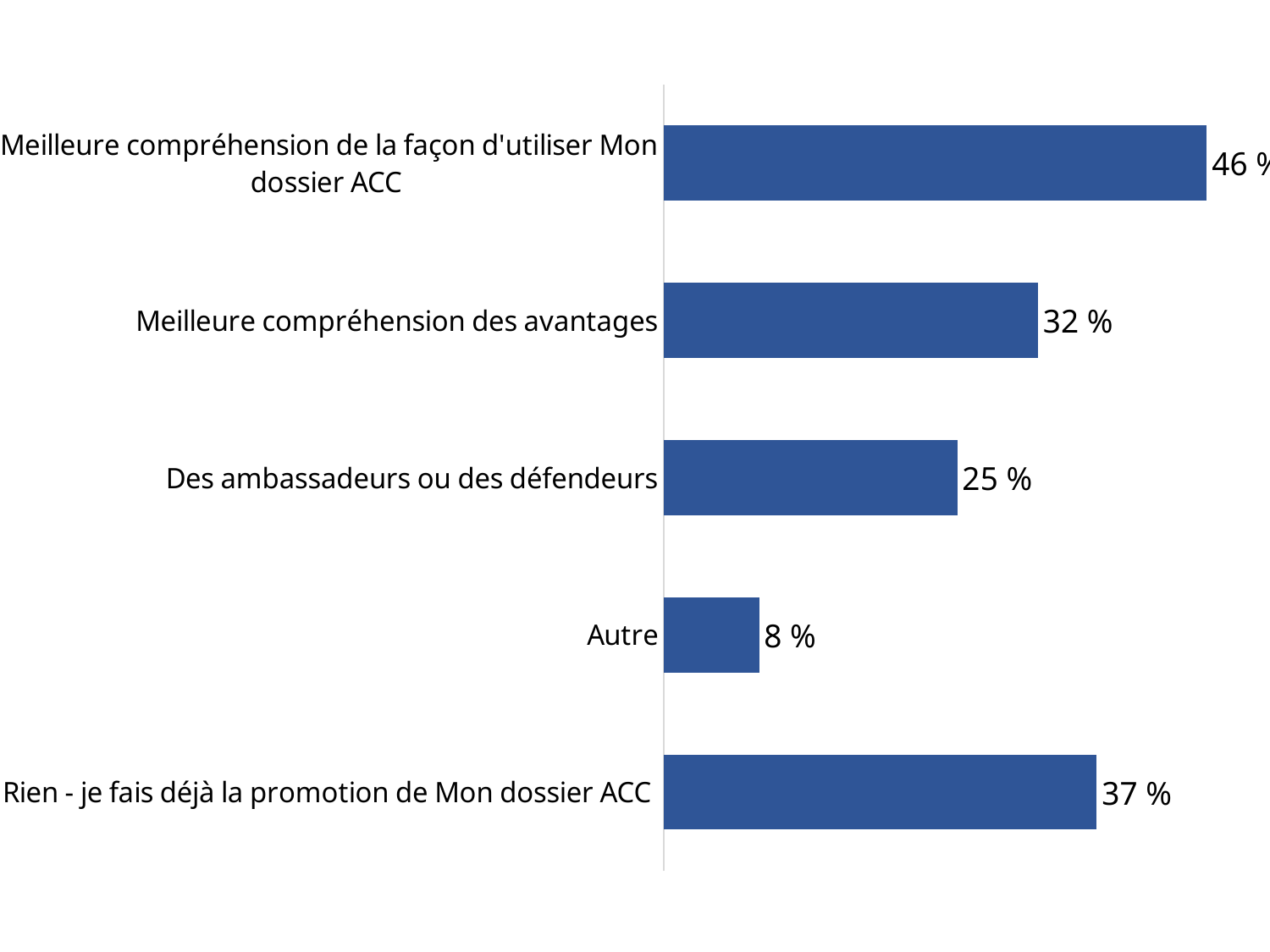
What is the value for "Autre"? 8 % What kind of chart is shown on the slide? Bar chart What is the value for "Des ambassadeurs ou des défendeurs"? 25 % Which category has the lowest value? Autre How many categories are shown in the chart? 5 What is the difference between the values for "Rien - je fais déjà la promotion de Mon dossier ACC" and "Meilleure compréhension des avantages"? 5 % What is the value for "Meilleure compréhension des avantages"? 32 % What is the value for "Meilleure compréhension de la façon d'utiliser Mon dossier ACC"? 46 % Which category has the highest value? Meilleure compréhension de la façon d'utiliser Mon dossier ACC What is the value for "Rien - je fais déjà la promotion de Mon dossier ACC"? 37 % What is the difference between the values for "Meilleure compréhension des avantages" and "Autre"? 24 % Which is larger: the value for "Rien - je fais déjà la promotion de Mon dossier ACC" or the value for "Des ambassadeurs ou des défendeurs"? Rien - je fais déjà la promotion de Mon dossier ACC